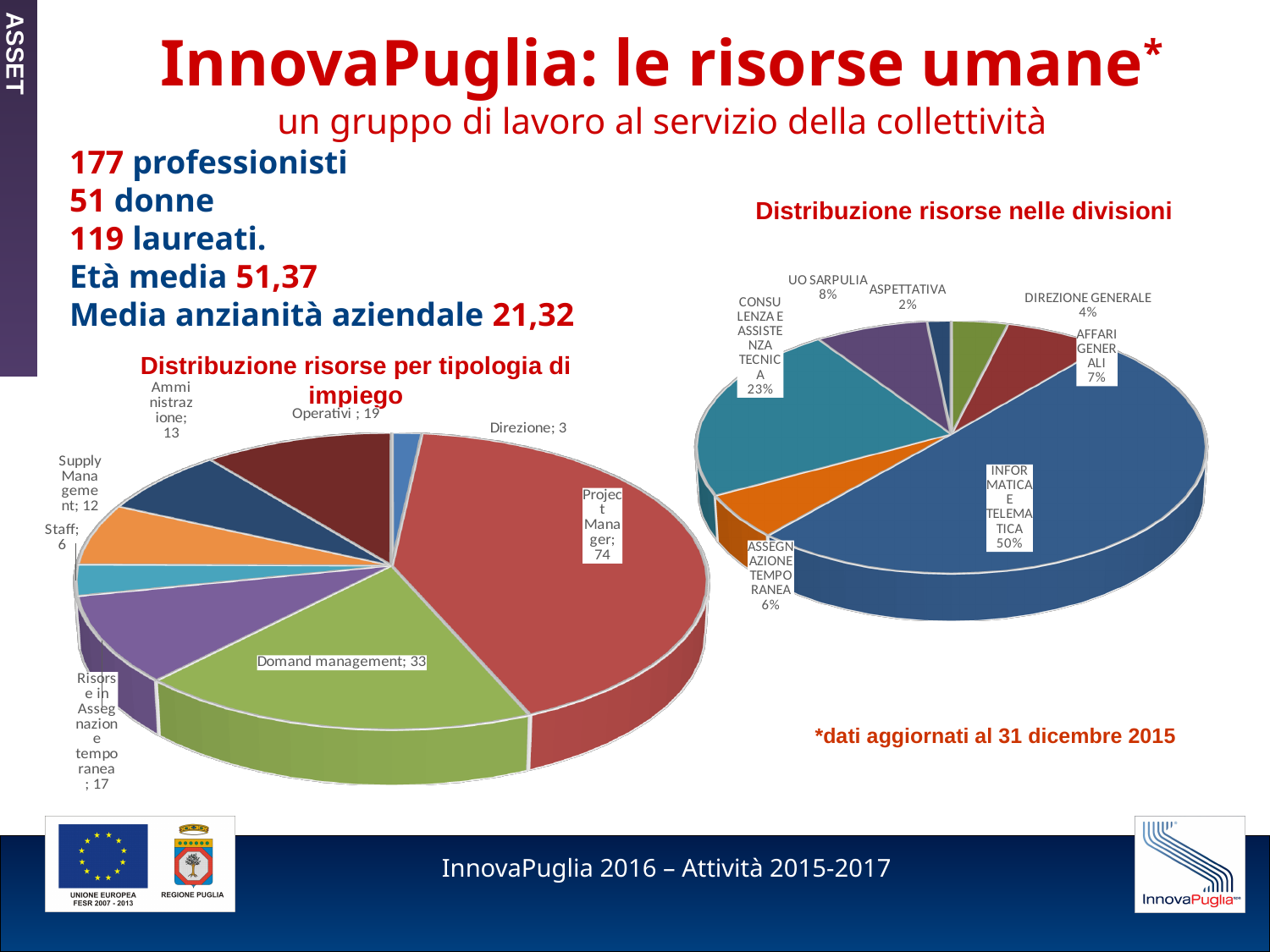
In the chart 'Distribuzione risorse per tipologia di impiego', what is the value for Project Manager? 74 In the chart 'Distribuzione risorse nelle divisioni', what share does INFORMATICA E TELEMATICA have? 50% In the chart 'Distribuzione risorse per tipologia di impiego', what is the value for Domand management? 33 In the chart 'Distribuzione risorse per tipologia di impiego', which is larger: Staff or Supply Management? Supply Management In the chart 'Distribuzione risorse nelle divisioni', what is the value for CONSULENZA E ASSISTENZA TECNICA? 23% In the chart 'Distribuzione risorse nelle divisioni', which division has the smallest share? ASPETTATIVA In the chart 'Distribuzione risorse per tipologia di impiego', what is the difference between Operativi and Amministrazione? 6 What type of chart is 'Distribuzione risorse nelle divisioni'? Pie chart How many categories does the chart 'Distribuzione risorse per tipologia di impiego' show? 8 In the chart 'Distribuzione risorse per tipologia di impiego', which category has the highest value? Project Manager In the chart 'Distribuzione risorse per tipologia di impiego', which category has the lowest value? Direzione In the chart 'Distribuzione risorse nelle divisioni', what is the difference between UO SARPULIA and ASSEGNAZIONE TEMPORANEA? 2%